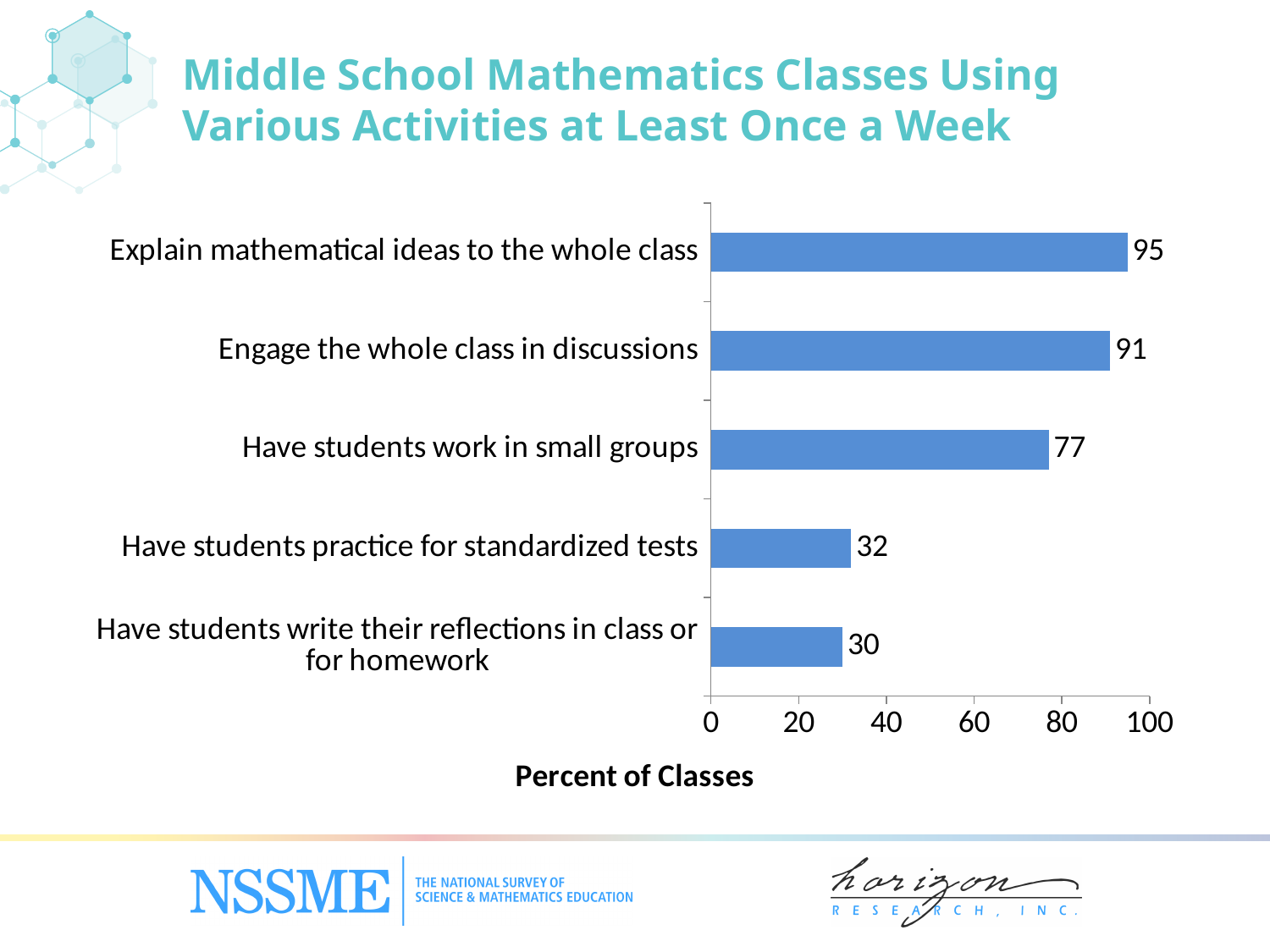
What is the difference between the values for 'Explain mathematical ideas to the whole class' and 'Have students work in small groups'? 18 What is the label of the horizontal axis? Percent of Classes Is the value for 'Have students work in small groups' greater or less than 60? greater What is the value for 'Have students practice for standardized tests'? 32 What percent of classes have students work in small groups at least once a week? 77 How many activities are shown in the chart? 5 Which is larger: the value for 'Engage the whole class in discussions' or 'Have students work in small groups'? Engage the whole class in discussions What is the value for 'Engage the whole class in discussions'? 91 Which activity has the highest percent of classes? Explain mathematical ideas to the whole class Which activity has the lowest percent of classes? Have students write their reflections in class or for homework What kind of chart is shown on the slide? bar chart What is the difference between the values for 'Have students practice for standardized tests' and 'Have students write their reflections in class or for homework'? 2